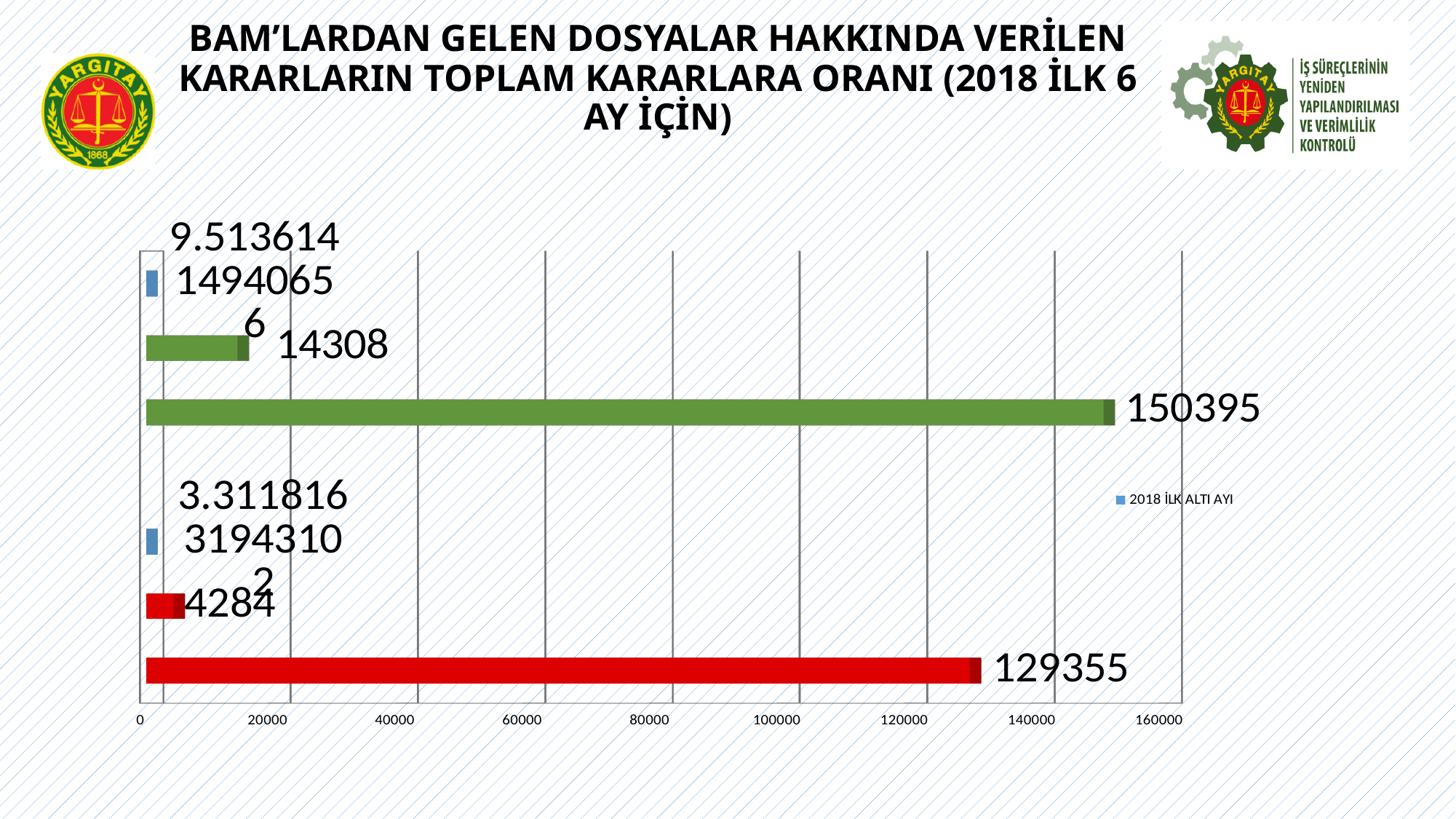
How many bars are plotted on the chart? 6 What is the value labelled on the longest green bar? 150395 What is the difference between the longest green bar (150395) and the longest red bar (129355)? 21040 What is the value labelled on the shorter red bar? 4284 Which is larger, the shorter green bar or the shorter red bar? The shorter green bar (14308) How many series does the legend list? 1 What is the highest value labelled on the chart? 150395 What is the value labelled on the longest red bar? 129355 What is the legend entry shown on the chart? 2018 İLK ALTI AYI What kind of chart is shown on the slide? Bar chart Is the value of the longest red bar greater or less than 140000? less What is the value labelled on the shorter green bar? 14308